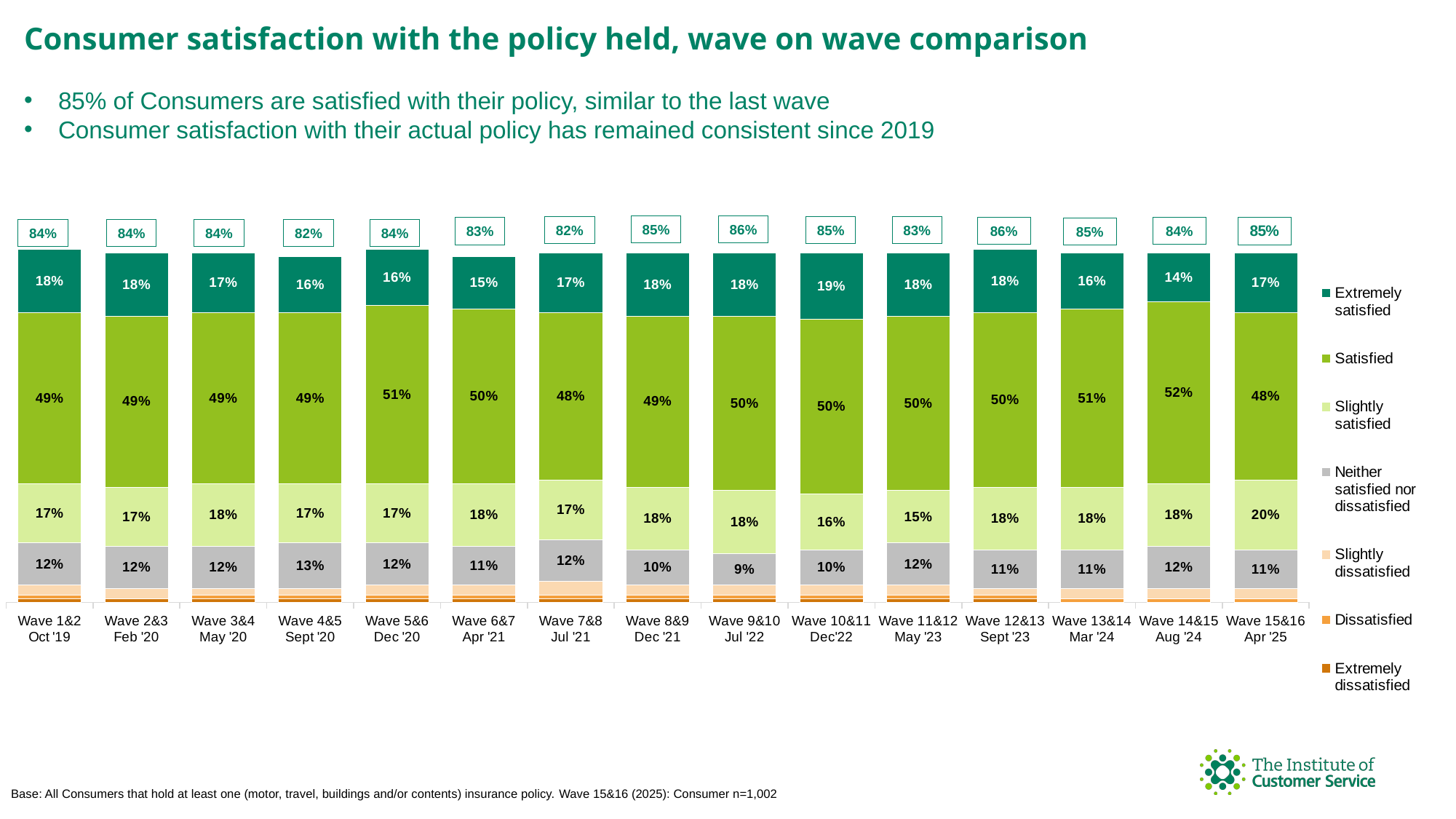
What percentage of consumers were 'Satisfied' in Wave 15&16 Apr '25? 48% What is the difference between the 'Slightly satisfied' values for Wave 15&16 Apr '25 and Wave 11&12 May '23? 5% Which wave has the lowest 'Extremely satisfied' value? Wave 14&15 Aug '24 What type of chart is shown on the slide? Stacked bar chart What is the 'Extremely satisfied' value for Wave 10&11 Dec'22? 19% Which wave has the lowest 'Neither satisfied nor dissatisfied' value? Wave 9&10 Jul '22 How many waves are shown on the x axis? 15 What is the title of the slide? Consumer satisfaction with the policy held, wave on wave comparison Which wave has the highest 'Satisfied' value? Wave 14&15 Aug '24 How many series does the legend list? 7 What is the boxed overall satisfaction figure shown above the Wave 9&10 Jul '22 bar? 86% Which is larger: the 'Extremely satisfied' value for Wave 1&2 Oct '19 or for Wave 14&15 Aug '24? Wave 1&2 Oct '19